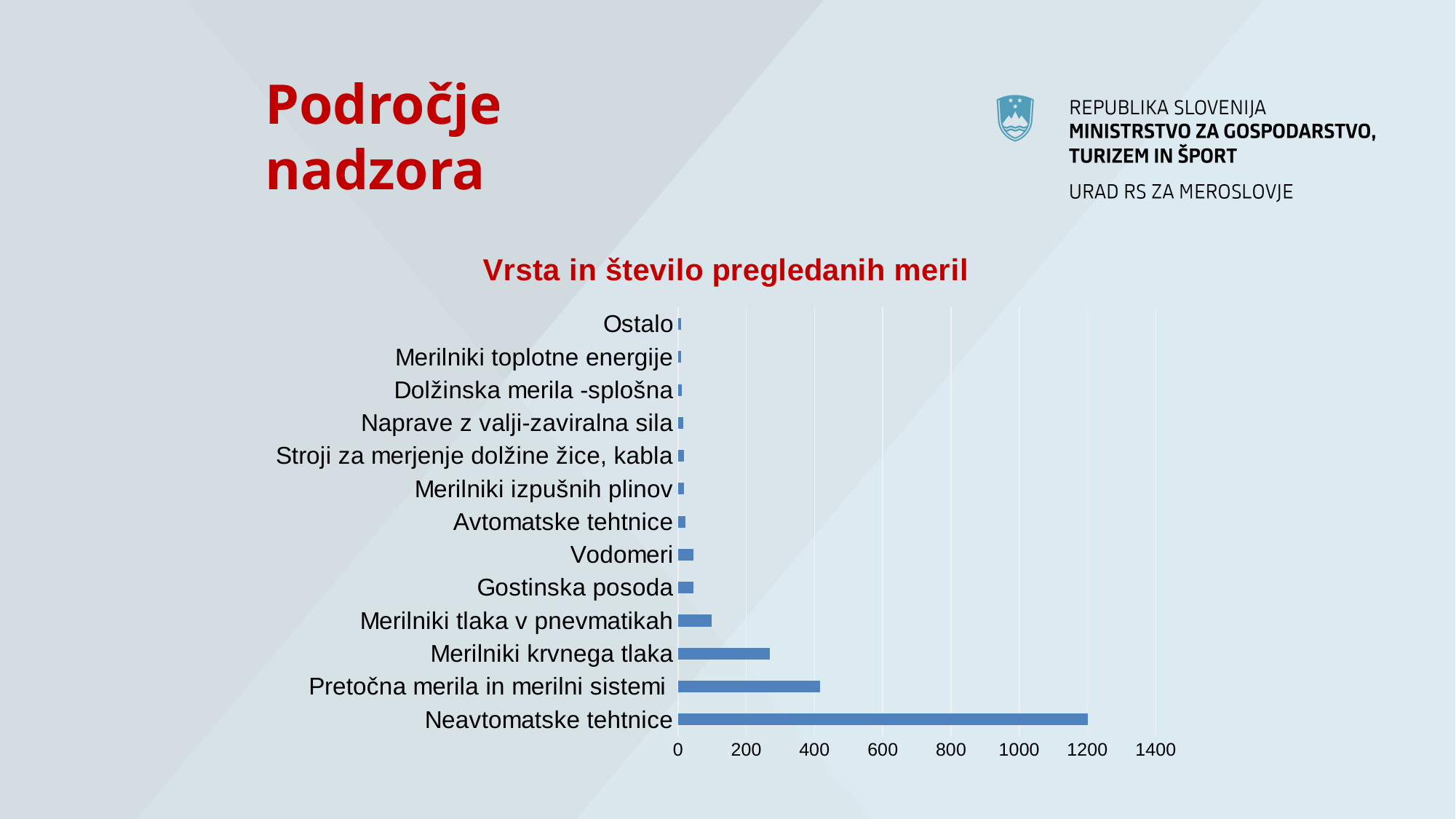
What kind of chart is shown on the slide? bar chart Which is larger, the value for Merilniki tlaka v pnevmatikah or the value for Neavtomatske tehtnice? Neavtomatske tehtnice What is the title of the chart? Vrsta in število pregledanih meril Is the value for Neavtomatske tehtnice greater or less than 1000? greater Is the value for Merilniki krvnega tlaka greater or less than 400? less Which category has the highest value? Neavtomatske tehtnice How many categories are plotted in the chart? 13 Which is larger, the value for Pretočna merila in merilni sistemi or the value for Merilniki krvnega tlaka? Pretočna merila in merilni sistemi Is the value for Pretočna merila in merilni sistemi greater or less than 600? less